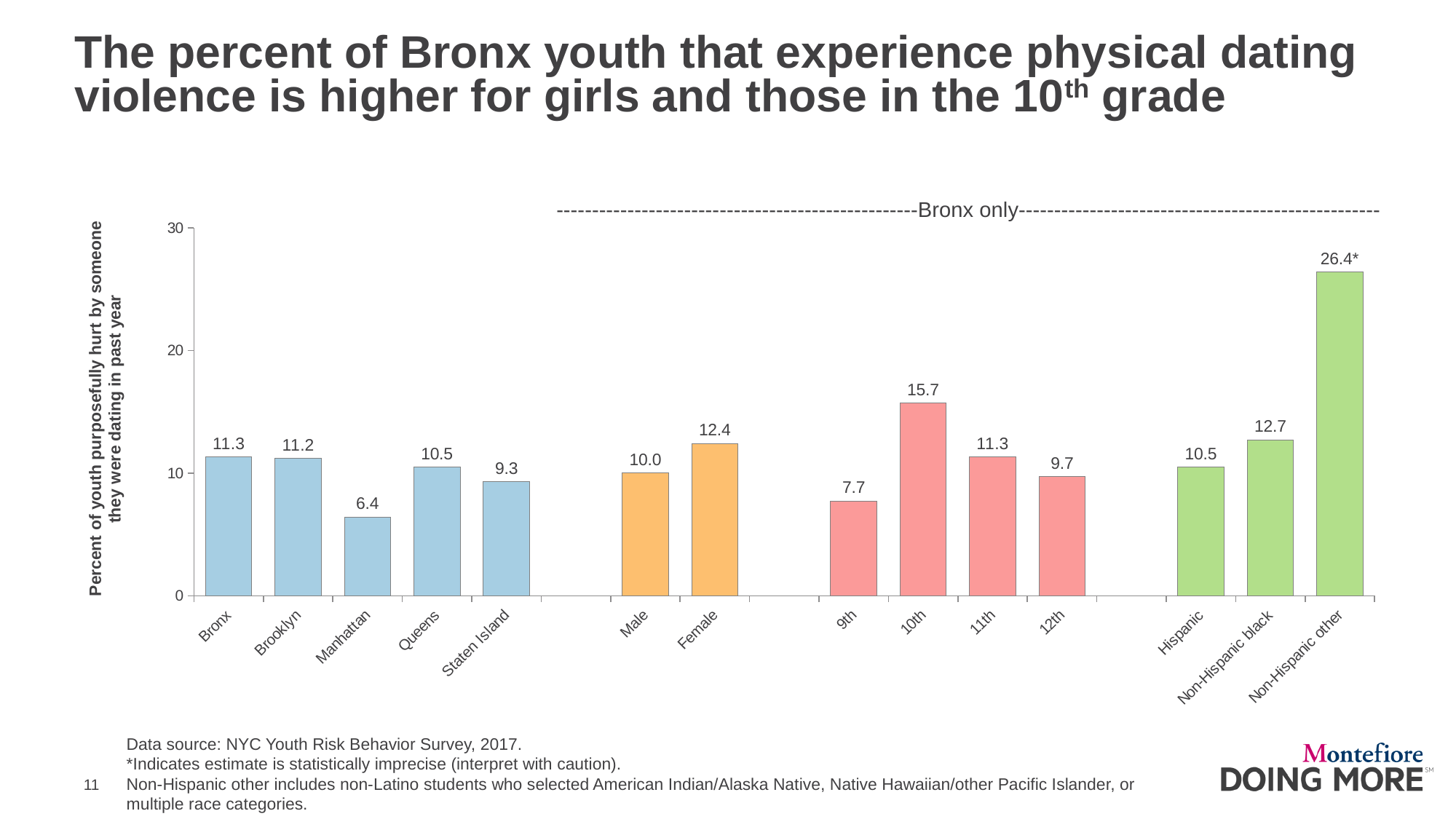
What is the label on the y axis? Percent of youth purposefully hurt by someone they were dating in past year What is the value for 10th grade? 15.7 Which is larger, the value for 9th grade or 12th grade? 12th What is the value for Non-Hispanic other? 26.4* What is the difference between the Female and Male values? 2.4 Which borough has the lowest value? Manhattan What is the value for Manhattan? 6.4 Which category has the highest value on the chart? Non-Hispanic other How many bars are plotted on the chart? 14 What is the value for Female? 12.4 What kind of chart is shown on the slide? bar chart Is the value for Non-Hispanic black greater or less than 10? greater